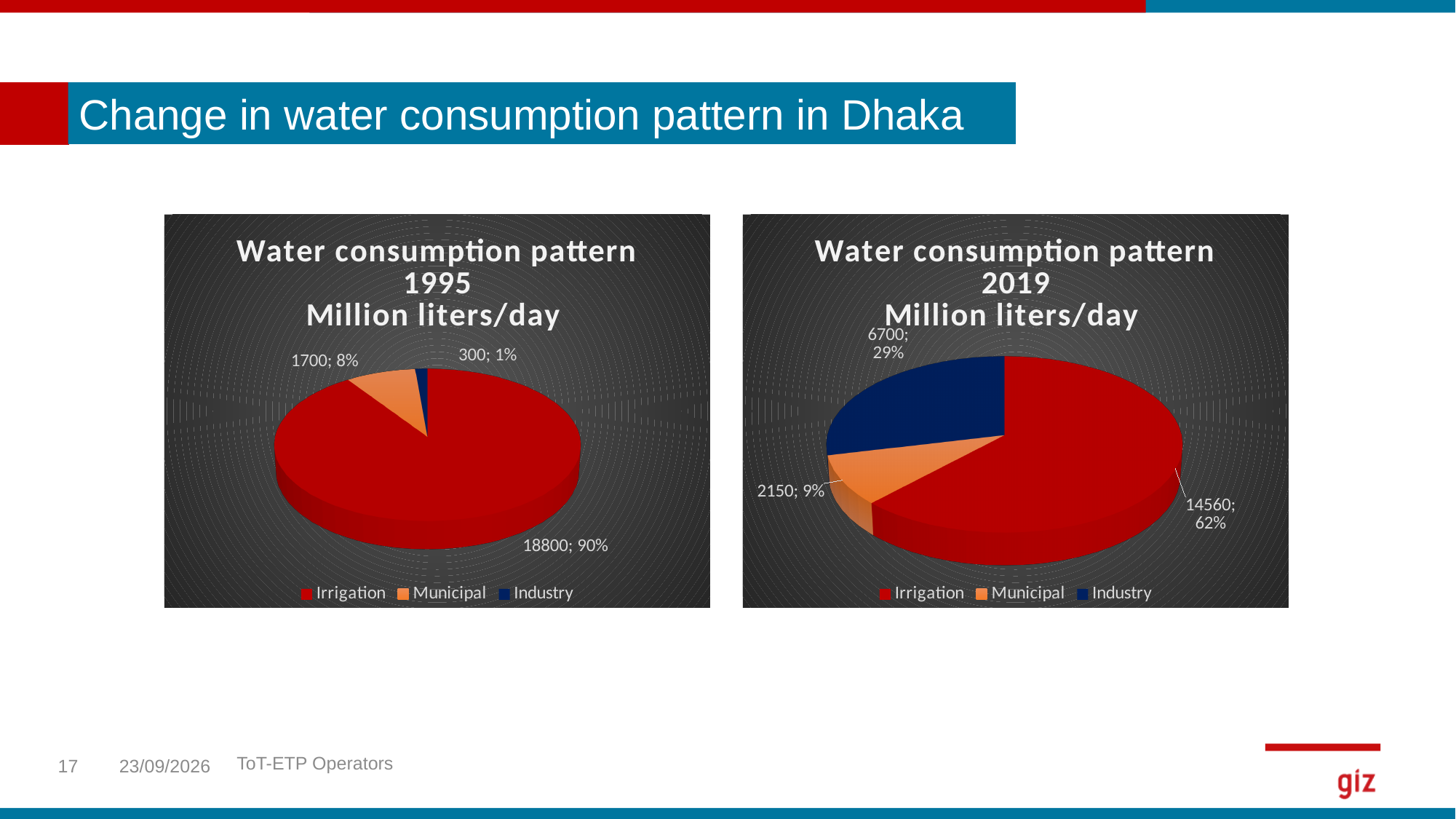
What type of chart is used for the 'Water consumption pattern 1995' chart? Pie chart In the 'Water consumption pattern 2019' chart, which is larger, Industry or Municipal? Industry In the 'Water consumption pattern 1995' chart, what value is shown for Irrigation? 18800 In the 'Water consumption pattern 2019' chart, what value is shown for Municipal? 2150 How many categories does the legend of the 'Water consumption pattern 2019' chart list? 3 In the 'Water consumption pattern 2019' chart, what value is shown for Industry? 6700 In the 'Water consumption pattern 2019' chart, what share of the pie does Irrigation take? 62% In the 'Water consumption pattern 1995' chart, what share of the pie does Municipal take? 8% In the 'Water consumption pattern 1995' chart, which category has the largest slice? Irrigation What is the difference between the Irrigation value in the 1995 chart and the Irrigation value in the 2019 chart? 4240 In the 'Water consumption pattern 2019' chart, which category has the smallest slice? Municipal In the 'Water consumption pattern 1995' chart, what value is shown for Industry? 300